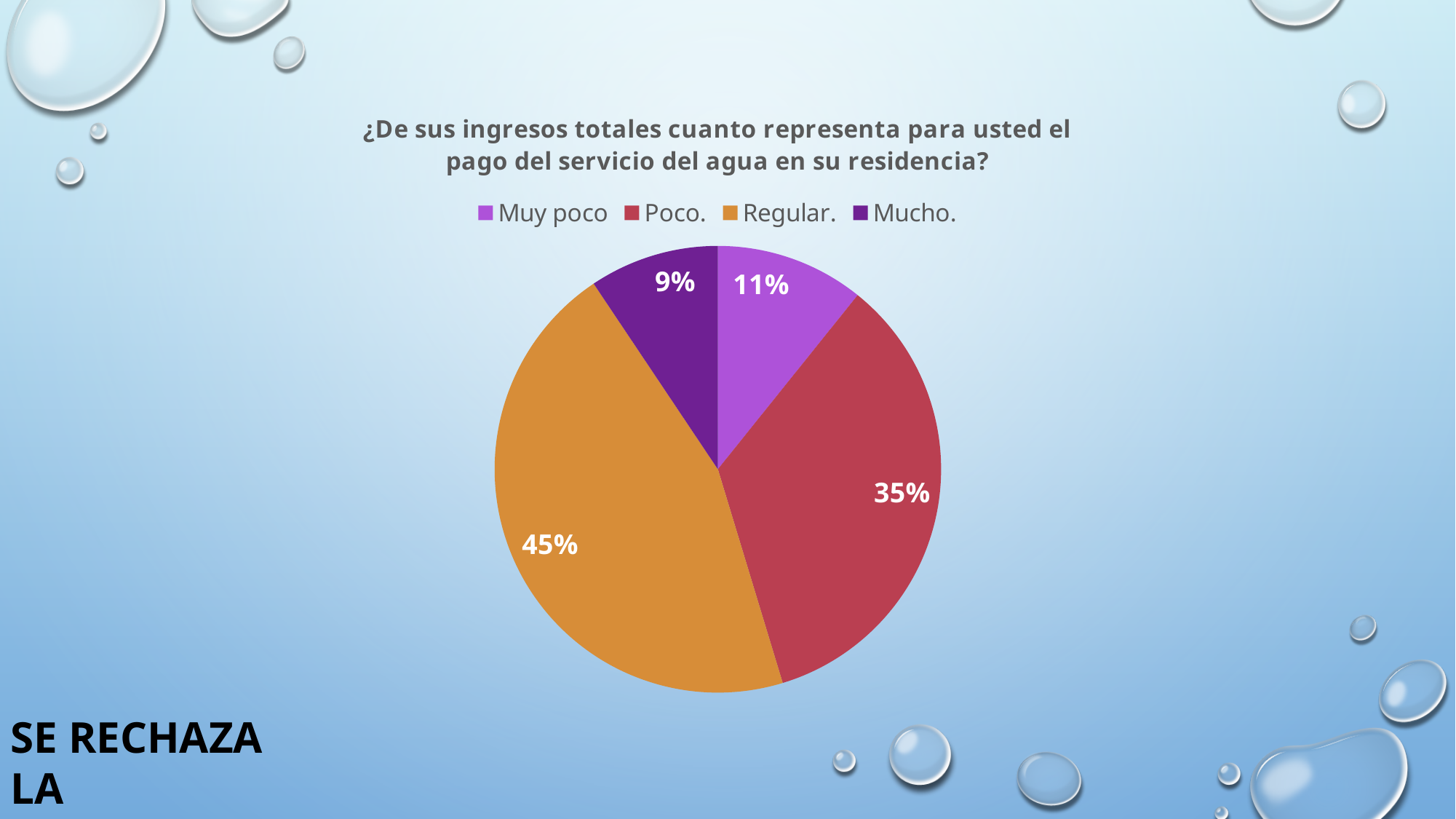
What percentage is shown for the "Muy poco" slice? 11% What percentage is shown for the "Poco." slice? 35% What percentage is shown for the "Mucho." slice? 9% What type of chart is shown on the slide? Pie chart What percentage of the pie does the "Regular." slice represent? 45% Which slice is larger, "Muy poco" or "Mucho."? Muy poco What is the difference in percentage points between the "Regular." and "Poco." slices? 10 How many categories does the pie chart show? 4 Which category has the largest share of the pie? Regular. Which category has the smallest share of the pie? Mucho. What colour is the "Regular." slice in the pie chart? Orange What is the combined percentage of the "Poco." and "Regular." slices? 80%